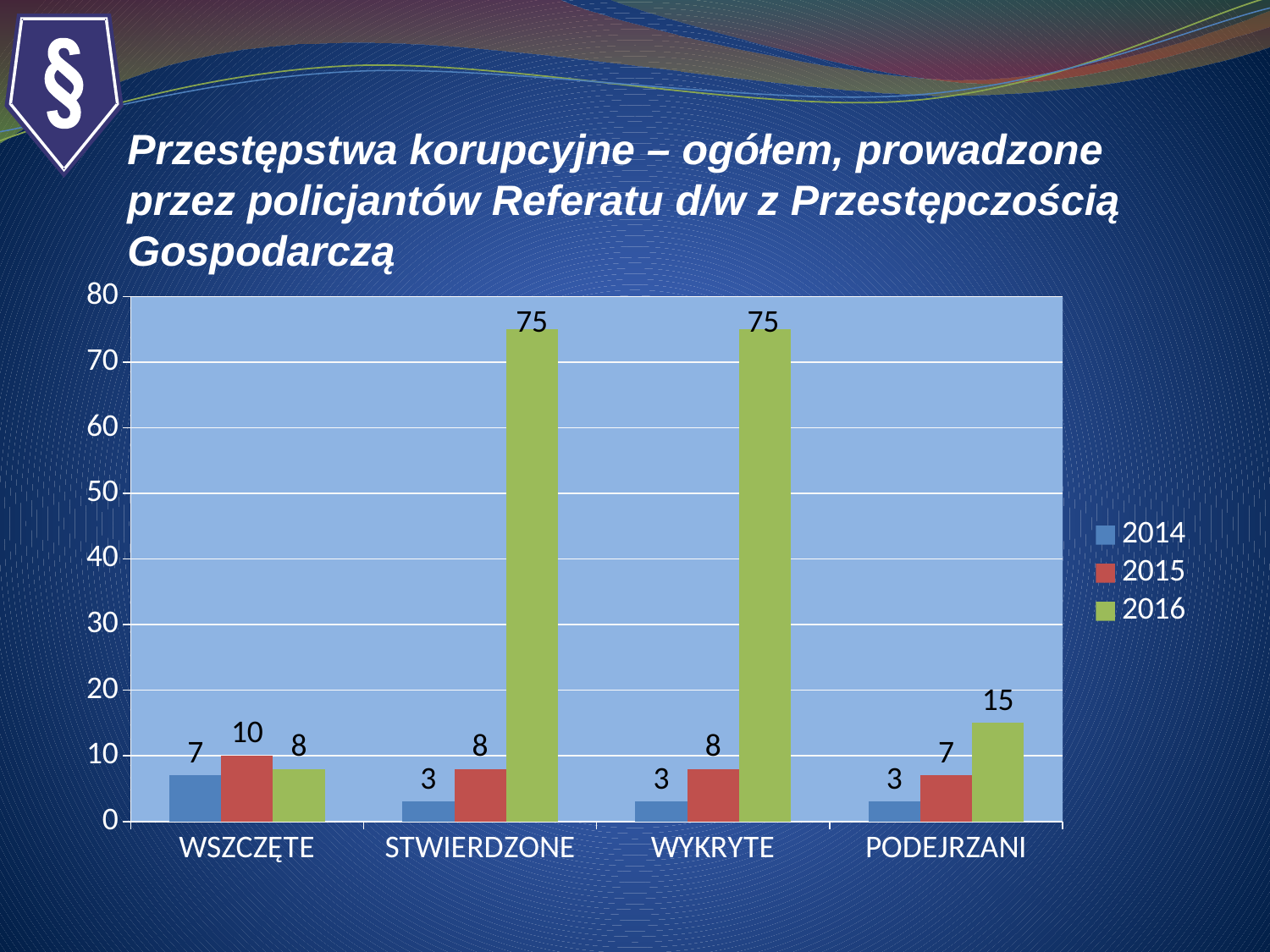
What is the value for 2016 in the STWIERDZONE category? 75 How many series does the legend list? 3 Which is larger in the WSZCZĘTE category, the 2014 value or the 2016 value? 2016 What kind of chart is shown on the slide? Bar chart Which series is shown in green in the legend? 2016 Which category has the highest value for the 2015 series? WSZCZĘTE What is the value for 2016 in the PODEJRZANI category? 15 Which category has the lowest value for the 2016 series? WSZCZĘTE What is the value for 2014 in the PODEJRZANI category? 3 What is the difference between the 2016 and 2014 values in the WYKRYTE category? 72 What is the value for 2015 in the WSZCZĘTE category? 10 How many categories are shown on the x axis? 4